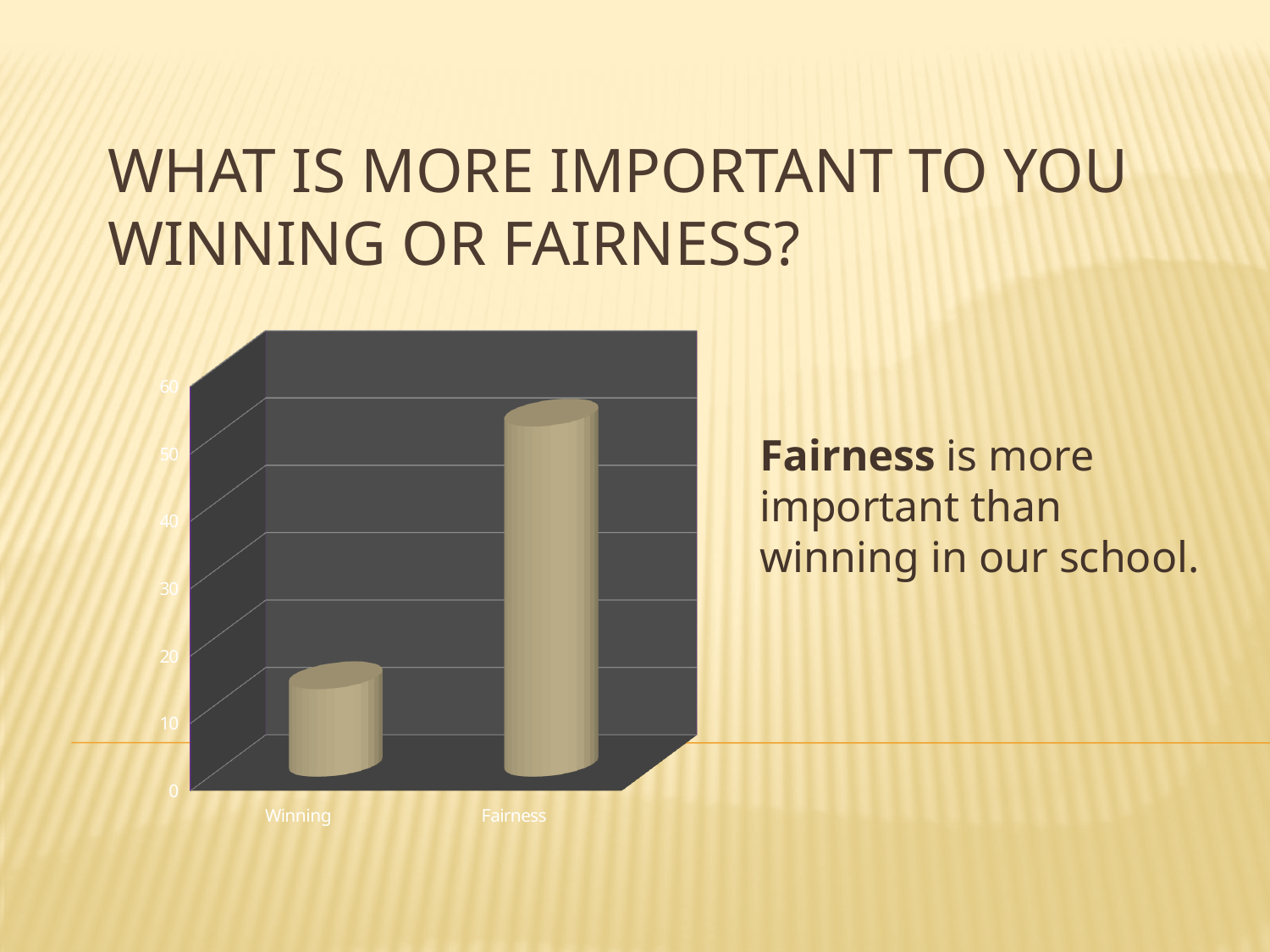
Do the values rise or fall going from Winning to Fairness along the x axis? rise What kind of chart is shown on the slide? bar chart What are the two category labels on the x axis of the chart? Winning and Fairness Which category has the lowest value in the chart? Winning Is the value for Winning greater or less than 30? less Which is larger, the value for Winning or the value for Fairness? Fairness What is the highest tick value shown on the vertical axis of the chart? 60 How many categories are shown on the x axis of the chart? 2 Which category has the highest value in the chart? Fairness Is the value for Fairness greater or less than 40? greater Is the value for Fairness greater or less than 60? less